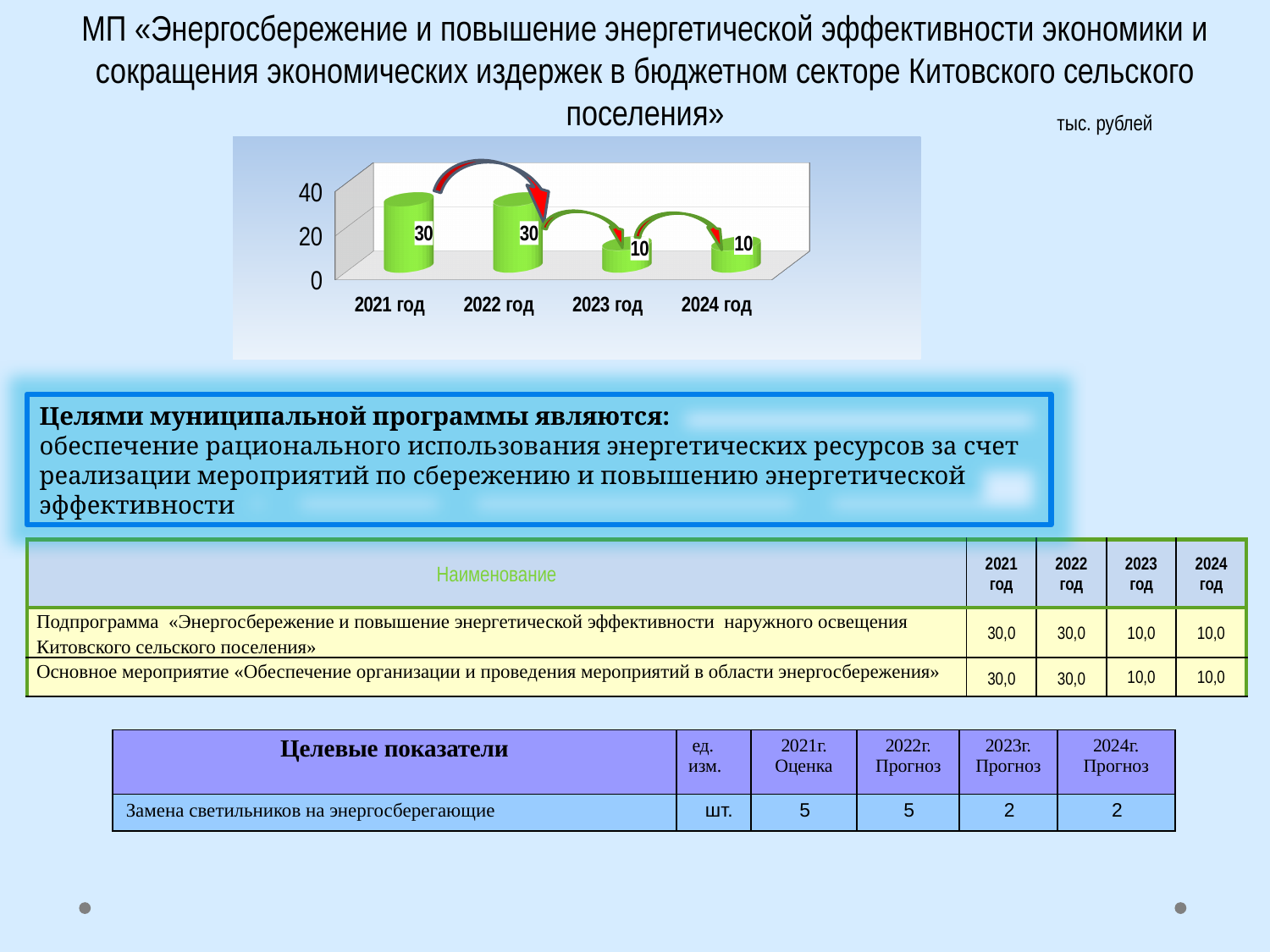
What is the value for 2022 год in the chart? 30 What is the difference between the values for 2022 год and 2023 год? 20 Is the value for 2021 год greater or less than 20? greater What unit of measurement is indicated for the chart values? тыс. рублей Is the value for 2024 год greater or less than 20? less What is the value for 2023 год in the chart? 10 What is the value for 2021 год in the chart? 30 Do the values rise or fall from 2021 год to 2024 год? fall How many categories (years) are shown on the x axis of the chart? 4 What is the value for 2024 год in the chart? 10 Which is larger, the value for 2021 год or the value for 2024 год? 2021 год What kind of chart is shown on the slide? bar chart